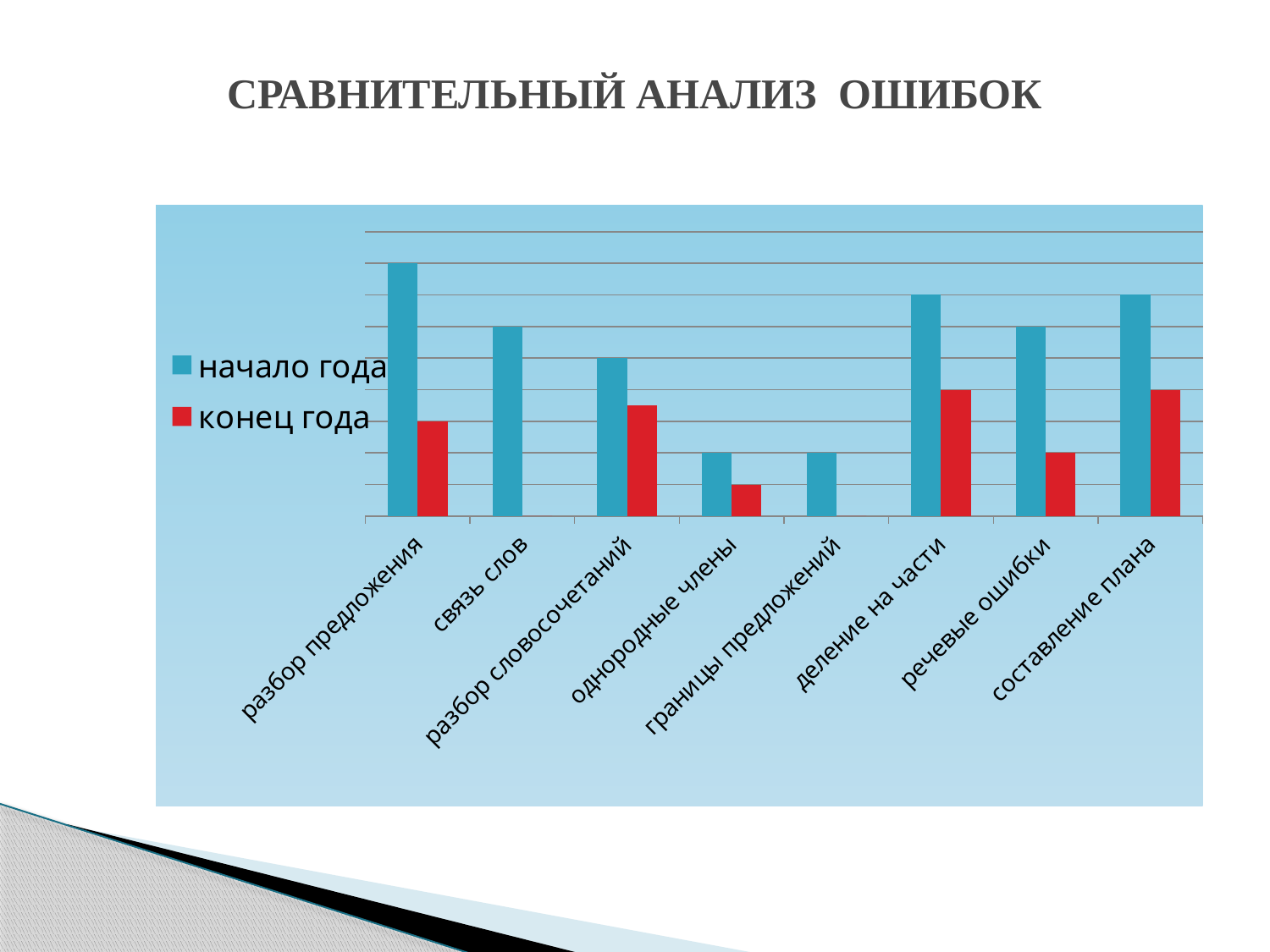
Which series is shown in red? конец года Which category has the highest value for начало года? разбор предложения Which is larger for конец года: составление плана or речевые ошибки? составление плана Which is larger for начало года: деление на части or речевые ошибки? деление на части How many categories are shown on the x axis? 8 What is the title of the slide? СРАВНИТЕЛЬНЫЙ АНАЛИЗ ОШИБОК Which is larger for конец года: разбор словосочетаний or речевые ошибки? разбор словосочетаний How many series does the legend list? 2 What kind of chart is shown on the slide? bar chart